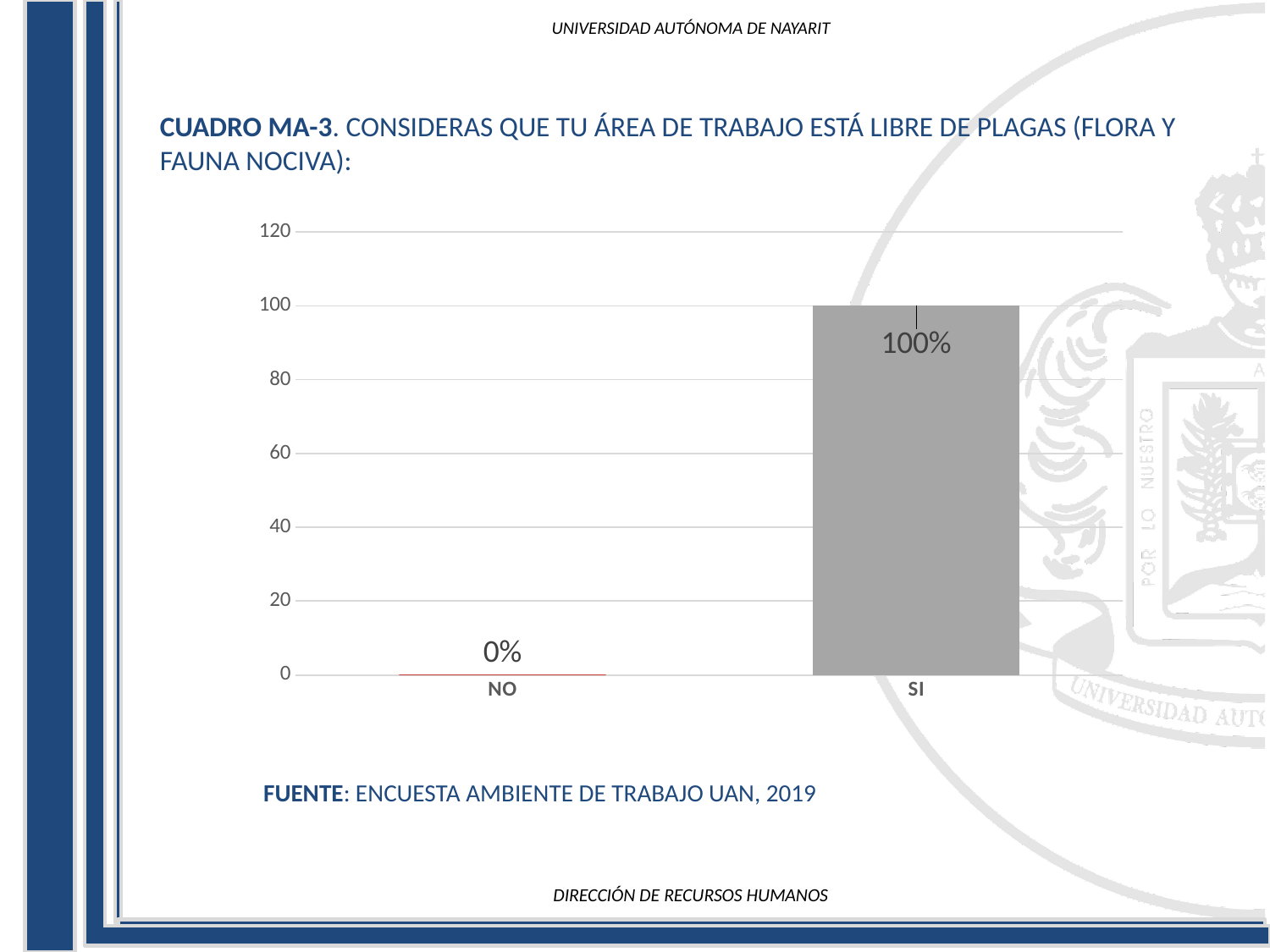
What is the value for SI? 100% What kind of chart is shown on the slide? bar chart What is the value for NO? 0% What is the highest tick value shown on the y axis? 120 What is the difference between the values for SI and NO? 100% Is the value for SI greater or less than 80? greater How many categories are shown on the x axis? 2 What source is cited below the chart? ENCUESTA AMBIENTE DE TRABAJO UAN, 2019 Which category has the highest value? SI Which category has the lowest value? NO Which is larger, the value for NO or the value for SI? SI